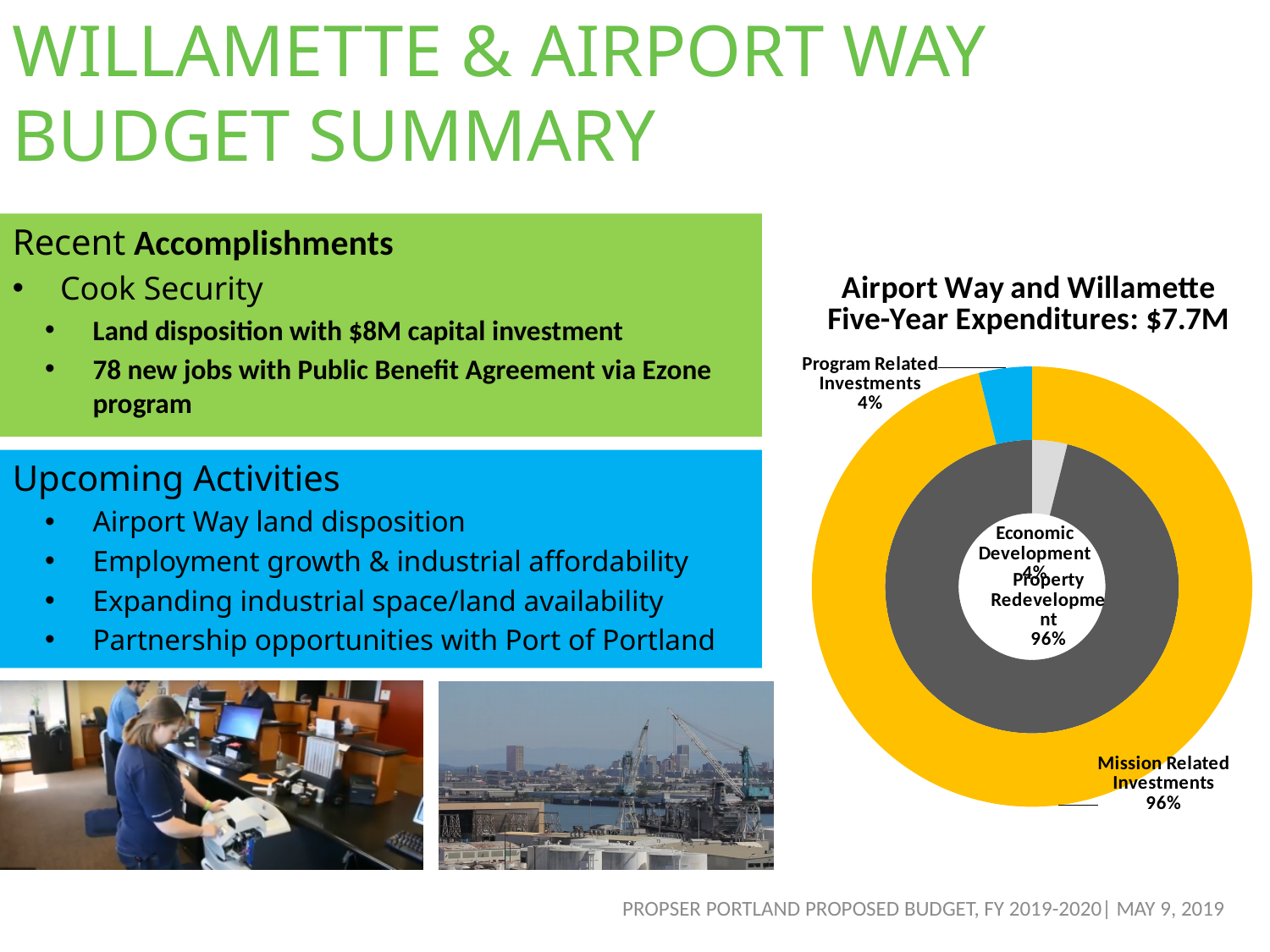
What kind of chart is shown on the slide? Doughnut chart What share of the inner ring is Property Redevelopment? 96% What total five-year expenditure amount is stated in the chart title? $7.7M What share of the outer ring is Mission Related Investments? 96% What share of the outer ring is Program Related Investments? 4% What is the difference in percentage points between Mission Related Investments and Program Related Investments? 92 percentage points Which category in the outer ring has the largest share? Mission Related Investments Which is larger, Property Redevelopment or Economic Development? Property Redevelopment Which category in the outer ring has the smallest share? Program Related Investments What is the title of the chart on the slide? Airport Way and Willamette Five-Year Expenditures: $7.7M Which category in the inner ring has the smallest share? Economic Development